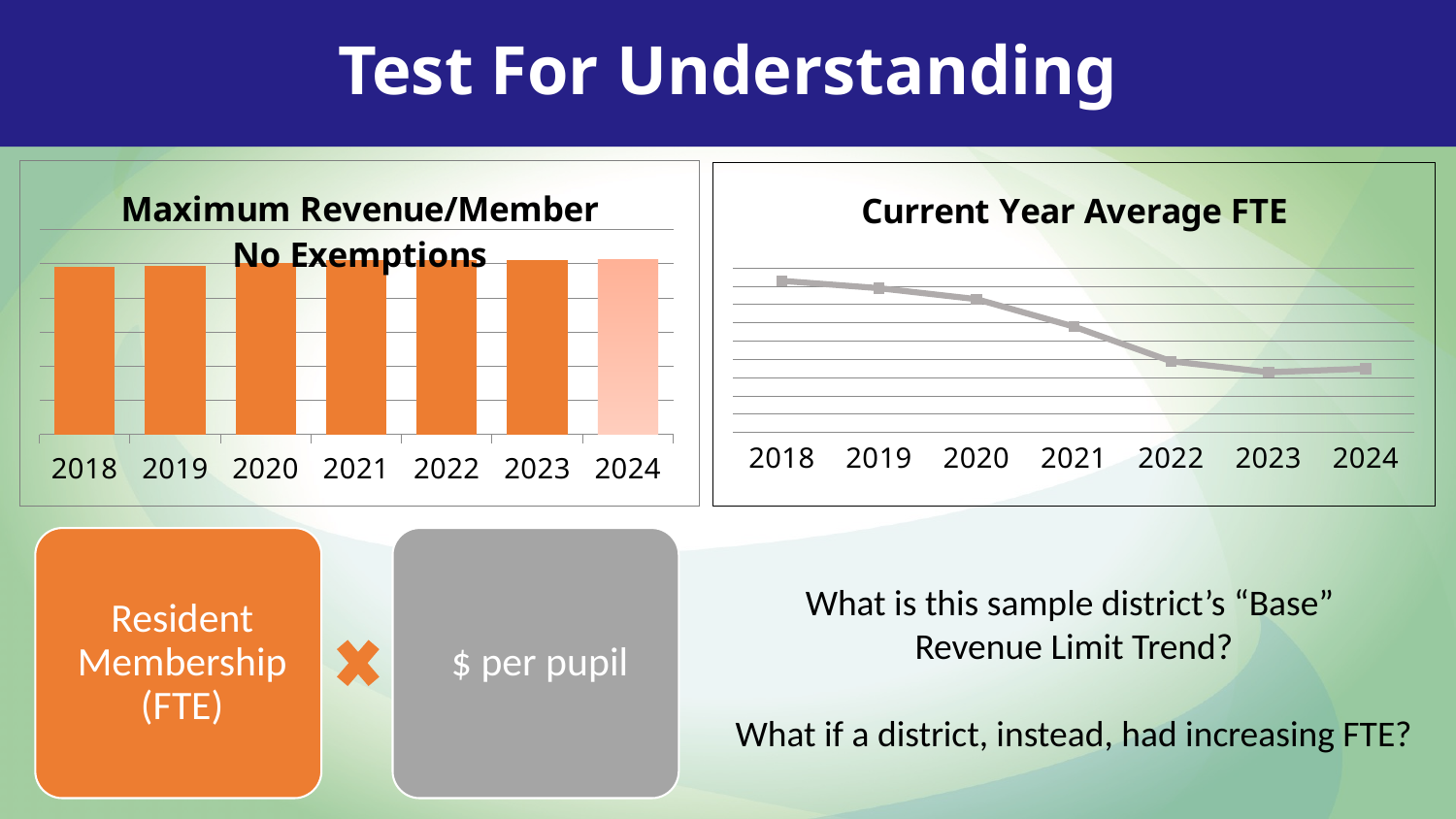
In the "Maximum Revenue/Member No Exemptions" chart, do the bars rise or fall from 2018 to 2024? rise What kind of chart is the "Current Year Average FTE" chart? line chart How many years are shown on the x axis of the "Maximum Revenue/Member No Exemptions" chart? 7 How many data points are plotted on the "Current Year Average FTE" chart? 7 In the "Current Year Average FTE" chart, which year has the lowest value? 2023 In the "Current Year Average FTE" chart, which is larger, the value for 2018 or the value for 2022? 2018 What kind of chart is the "Maximum Revenue/Member No Exemptions" chart? bar chart In the "Current Year Average FTE" chart, does the line rise or fall from 2018 to 2023? fall What is the title of the chart on the right side of the slide? Current Year Average FTE In the "Current Year Average FTE" chart, which year has the highest value? 2018 In the "Maximum Revenue/Member No Exemptions" chart, which is larger, the bar for 2018 or the bar for 2023? 2023 In the "Maximum Revenue/Member No Exemptions" chart, which year's bar is drawn in a lighter shade than the others? 2024